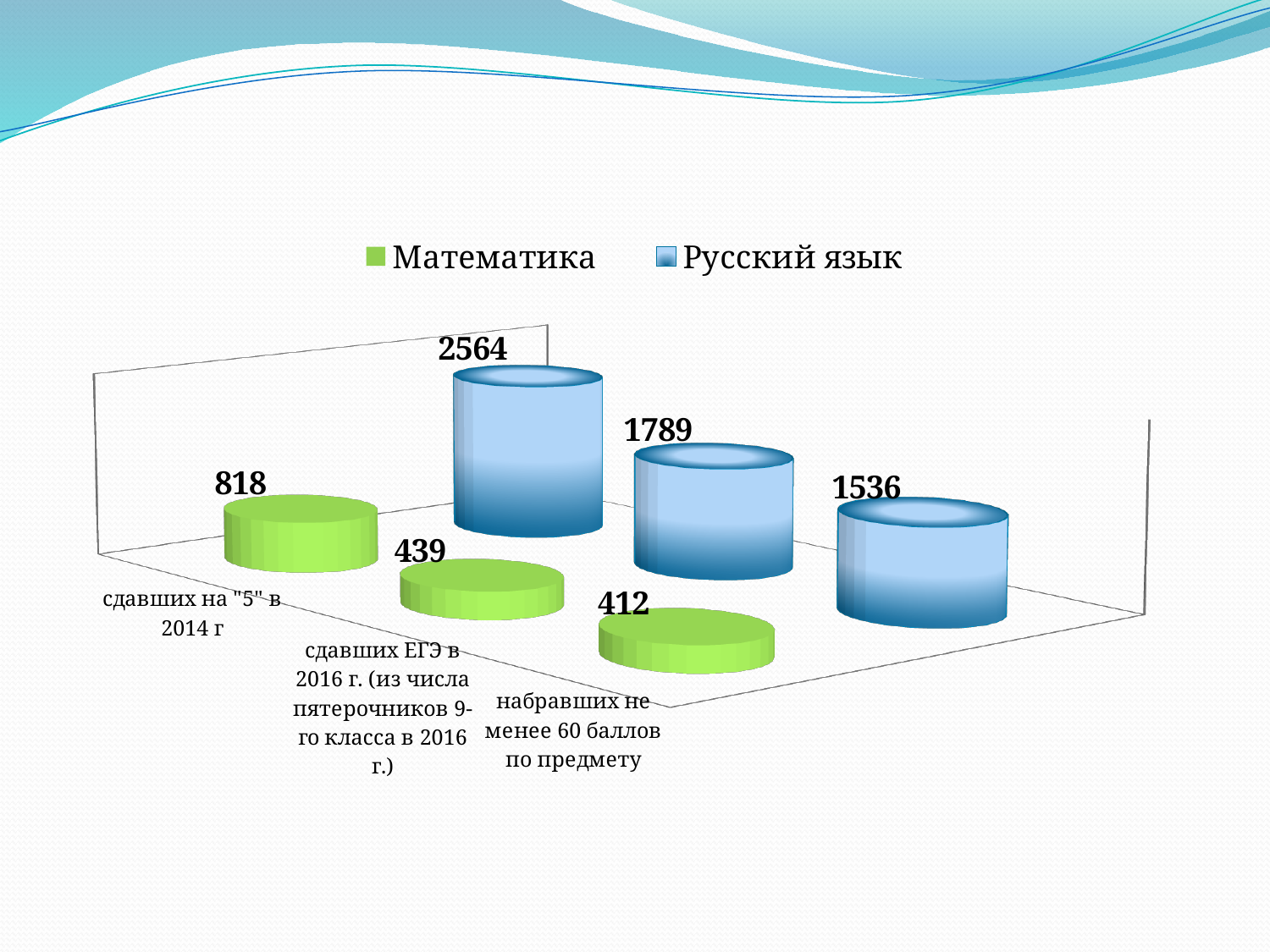
What is the difference between the Математика values for 'сдавших ЕГЭ в 2016 г.' and 'набравших не менее 60 баллов по предмету'? 27 What is the value for Математика in the category 'сдавших на "5" в 2014 г'? 818 What is the value for Математика in the category 'набравших не менее 60 баллов по предмету'? 412 What is the value for Русский язык in the category 'сдавших ЕГЭ в 2016 г. (из числа пятерочников 9-го класса в 2016 г.)'? 1789 Do the Русский язык values rise or fall from left to right across the categories? fall Which category has the lowest value for Математика? набравших не менее 60 баллов по предмету Which is larger: the Русский язык value for 'сдавших ЕГЭ в 2016 г.' or for 'набравших не менее 60 баллов по предмету'? сдавших ЕГЭ в 2016 г. Which category has the highest value for Русский язык? сдавших на "5" в 2014 г What is the difference between the Русский язык and Математика values in the category 'сдавших на "5" в 2014 г'? 1746 How many categories are shown on the x axis? 3 What is the value for Русский язык in the category 'сдавших на "5" в 2014 г'? 2564 How many series does the legend list? 2